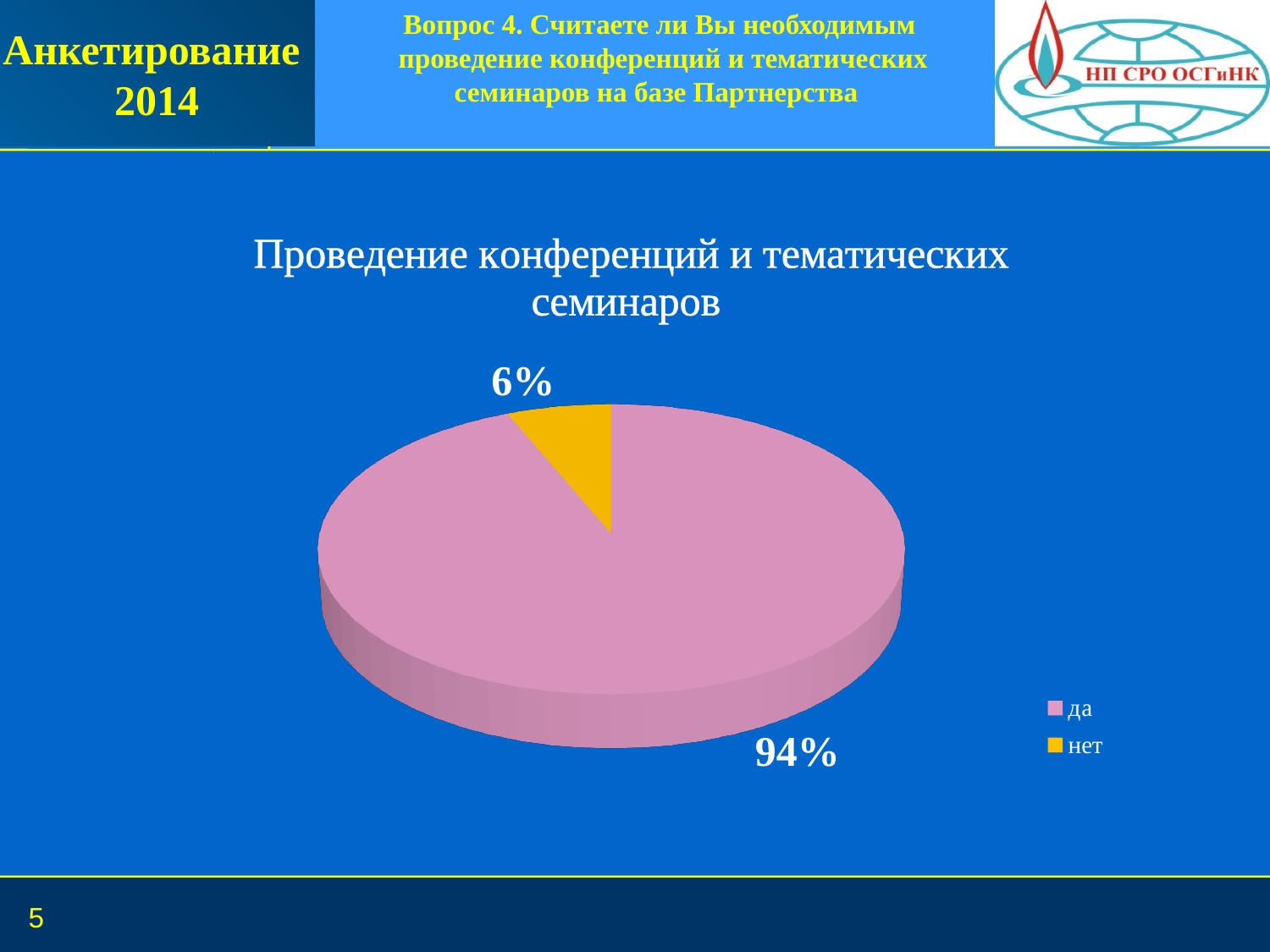
What percentage of the pie corresponds to "нет"? 6% Which category has the smallest share of the pie? нет What percentage of the pie corresponds to "да"? 94% What colour is the slice for "нет"? yellow How many slices does the pie chart have? 2 How many entries does the legend list? 2 What is the difference in percentage points between the "да" and "нет" slices? 88 Which category has the largest share of the pie? да What kind of chart is shown on the slide? pie chart What is the title of the chart? Проведение конференций и тематических семинаров Which is larger, the share for "да" or the share for "нет"? да